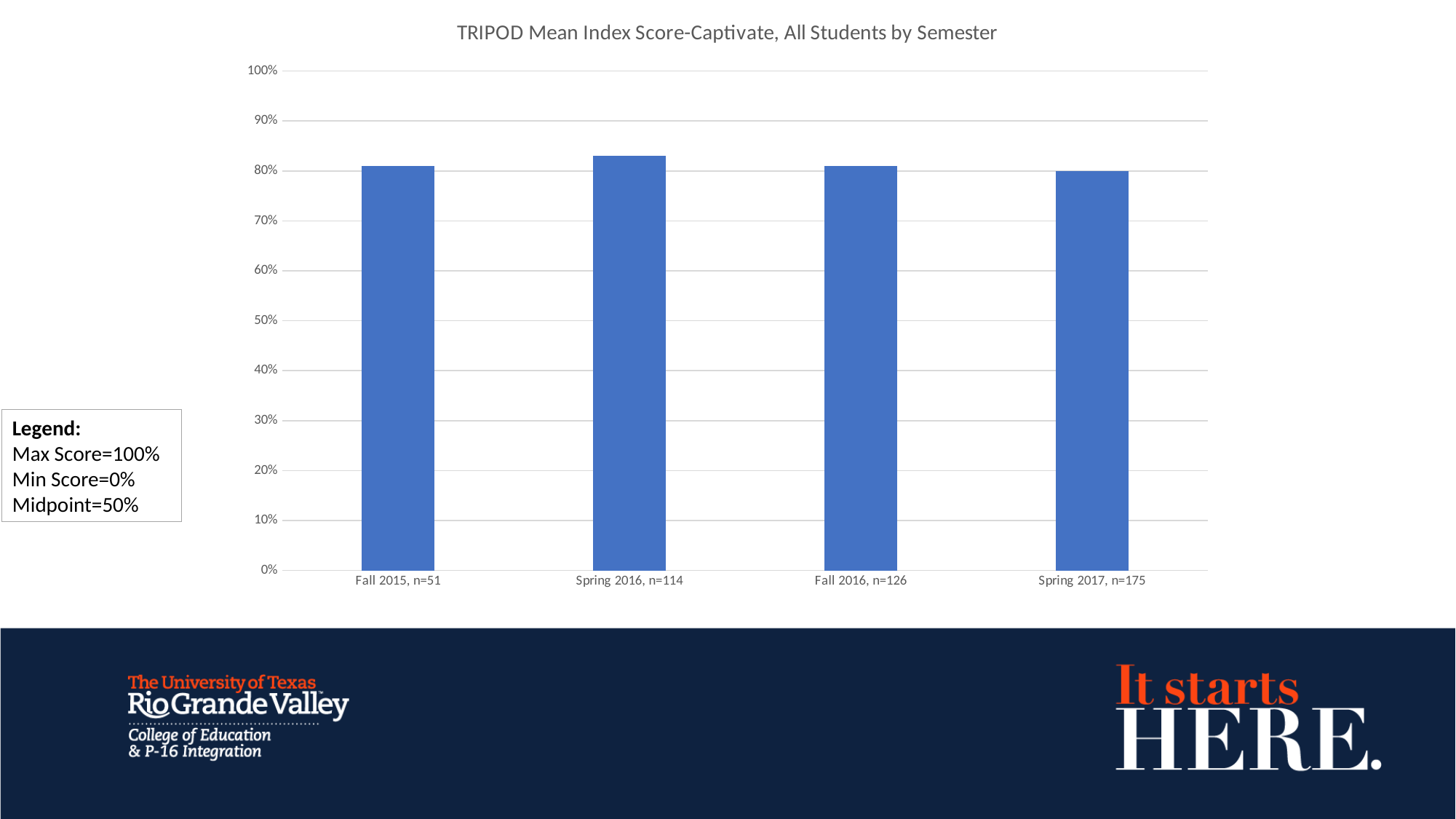
Is the value for Spring 2016, n=114 greater or less than 80%? greater What is the sample size (n) shown for Fall 2016? 126 Which semester has the highest mean index score? Spring 2016, n=114 What kind of chart is shown on the slide? bar chart Which is larger, the value for Spring 2016, n=114 or the value for Fall 2015, n=51? Spring 2016, n=114 What is the title of the chart? TRIPOD Mean Index Score-Captivate, All Students by Semester How many semesters (bars) are shown in the chart? 4 Is the value for Spring 2016, n=114 greater or less than 90%? less Which is larger, the value for Spring 2016, n=114 or the value for Spring 2017, n=175? Spring 2016, n=114 Is the value for Spring 2017, n=175 greater or less than 90%? less